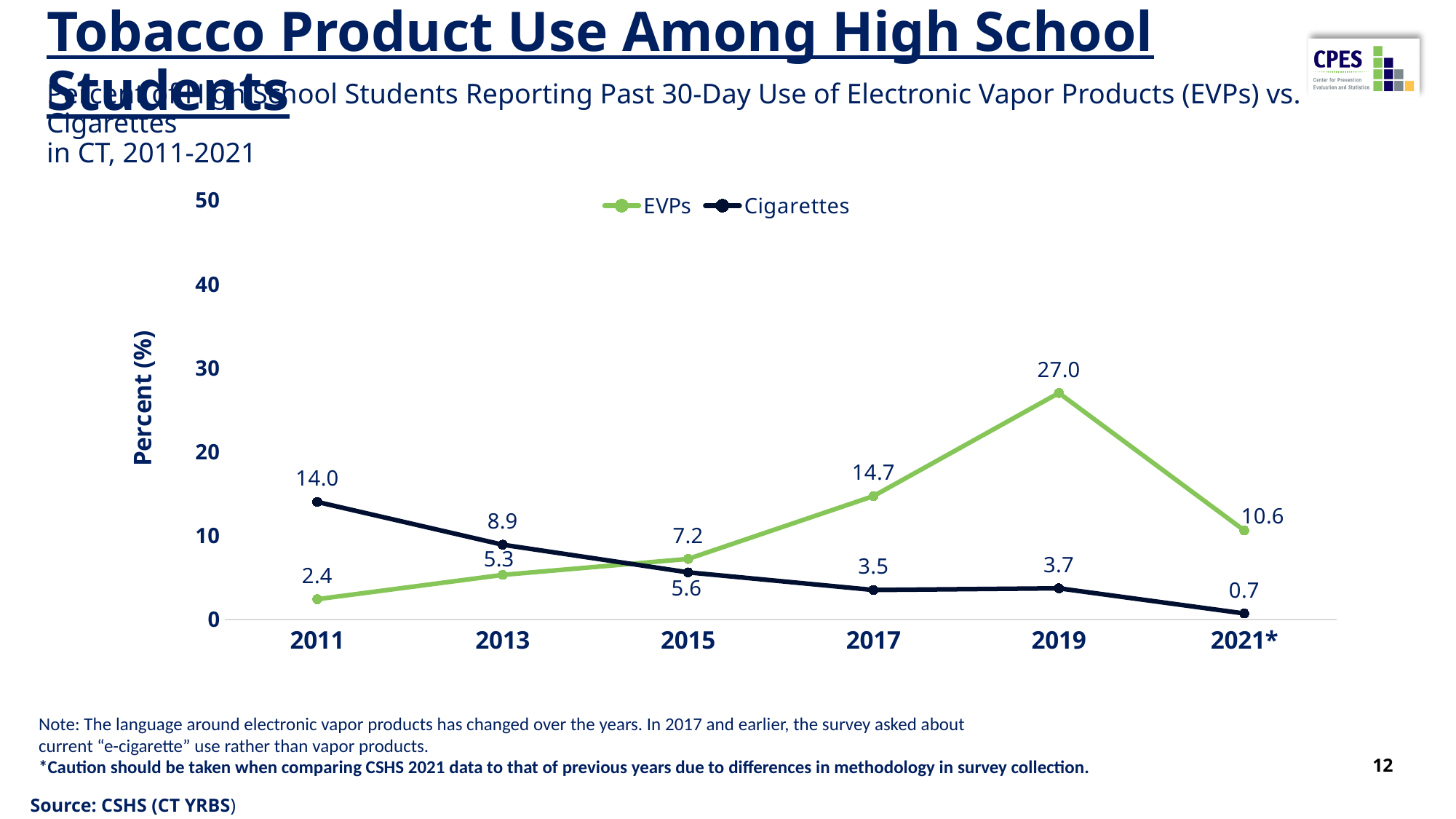
What is the difference between EVP use and cigarette use in 2019? 23.3 Which was higher in 2013, EVPs or Cigarettes? Cigarettes In which year was cigarette use lowest? 2021* Is the EVP value for 2017 greater or less than 10? greater What percent of high school students reported past 30-day use of EVPs in 2019? 27.0 How many years are shown on the x axis? 6 What was the EVP use value in 2021*? 10.6 How many series does the legend list? 2 Does cigarette use rise or fall from 2011 to 2021*? Fall In which year was EVP use highest? 2019 What kind of chart is shown? Line chart What was the cigarette use value in 2011? 14.0